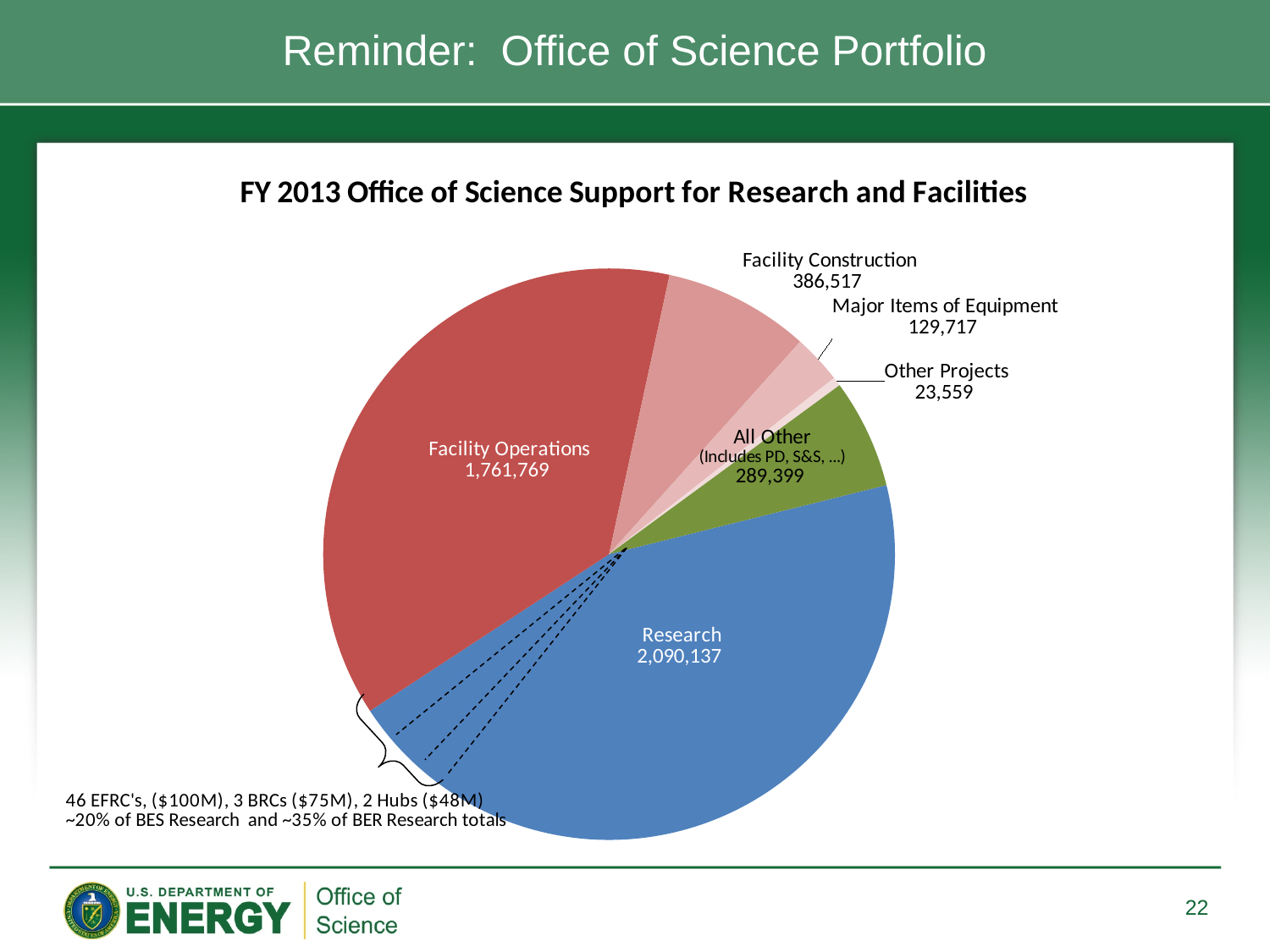
Which category has the smallest slice of the pie? Other Projects What is the value shown for Research? 2,090,137 What is the value shown for the All Other slice? 289,399 What is the difference between the Research value and the Facility Operations value? 328,368 What is the value shown for Facility Construction? 386,517 What is the title of the chart? FY 2013 Office of Science Support for Research and Facilities How many slices does the pie chart have? 6 What is the value shown for Facility Operations? 1,761,769 Which is larger, Facility Construction or All Other? Facility Construction Which category has the largest slice of the pie? Research What is the value shown for Other Projects? 23,559 What is the value shown for Major Items of Equipment? 129,717